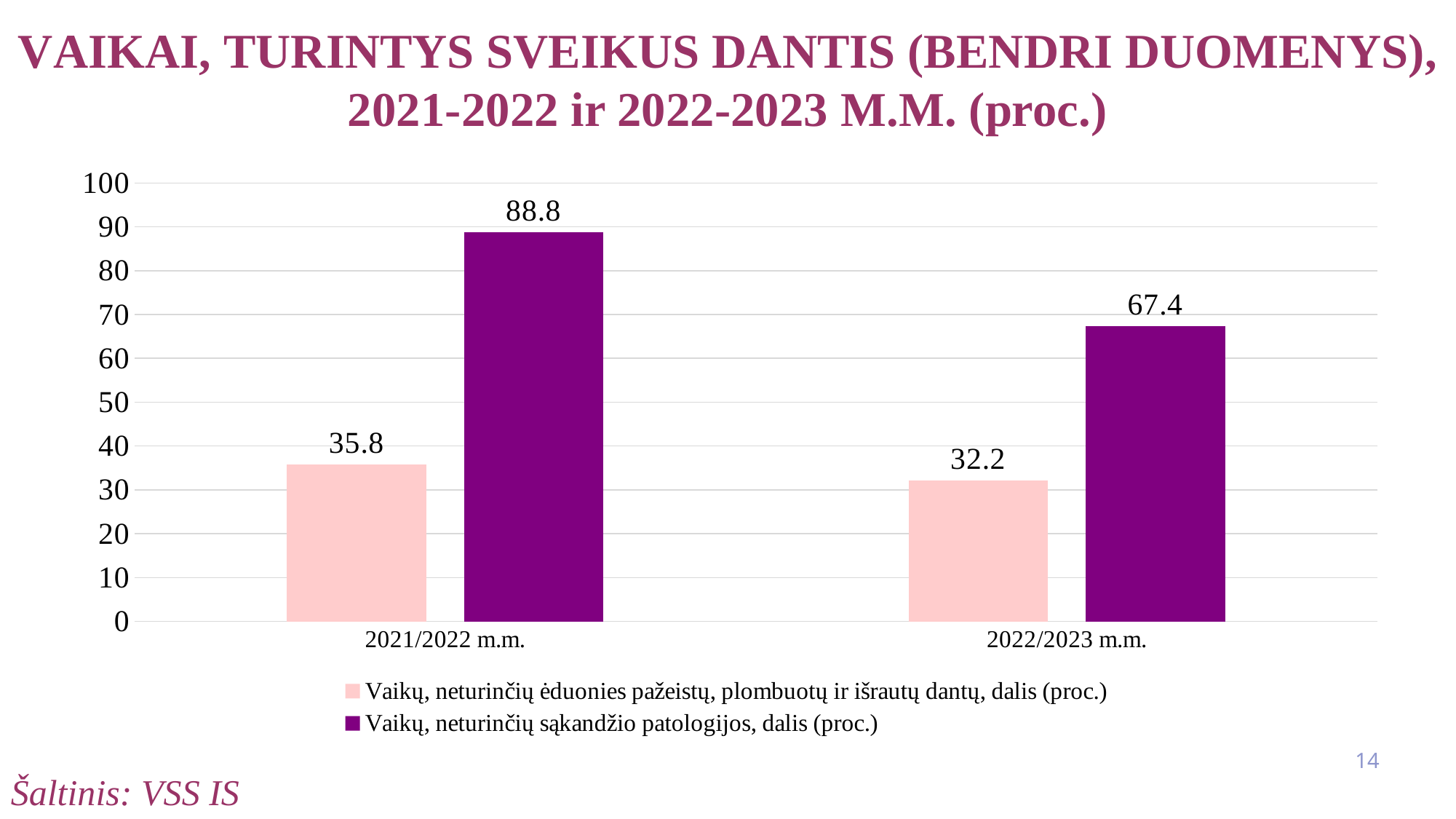
What is the difference between the 'Vaikų, neturinčių ėduonies pažeistų, plombuotų ir išrautų dantų, dalis (proc.)' values for 2021/2022 m.m. and 2022/2023 m.m.? 3.6 Which is larger: the 'Vaikų, neturinčių ėduonies pažeistų, plombuotų ir išrautų dantų, dalis (proc.)' value in 2021/2022 m.m. or in 2022/2023 m.m.? 2021/2022 m.m. What is the difference between the 'Vaikų, neturinčių sąkandžio patologijos, dalis (proc.)' values for 2021/2022 m.m. and 2022/2023 m.m.? 21.4 What kind of chart is shown on the slide? Bar chart What is the value for 'Vaikų, neturinčių sąkandžio patologijos, dalis (proc.)' in 2021/2022 m.m.? 88.8 What is the value for 'Vaikų, neturinčių ėduonies pažeistų, plombuotų ir išrautų dantų, dalis (proc.)' in 2022/2023 m.m.? 32.2 What is the value for 'Vaikų, neturinčių ėduonies pažeistų, plombuotų ir išrautų dantų, dalis (proc.)' in 2021/2022 m.m.? 35.8 Which bar has the lowest value on the chart? Vaikų, neturinčių ėduonies pažeistų, plombuotų ir išrautų dantų, dalis (proc.) in 2022/2023 m.m. How many categories are shown on the x axis? 2 What is the value for 'Vaikų, neturinčių sąkandžio patologijos, dalis (proc.)' in 2022/2023 m.m.? 67.4 How many series does the legend list? 2 Which bar has the highest value on the chart? Vaikų, neturinčių sąkandžio patologijos, dalis (proc.) in 2021/2022 m.m.